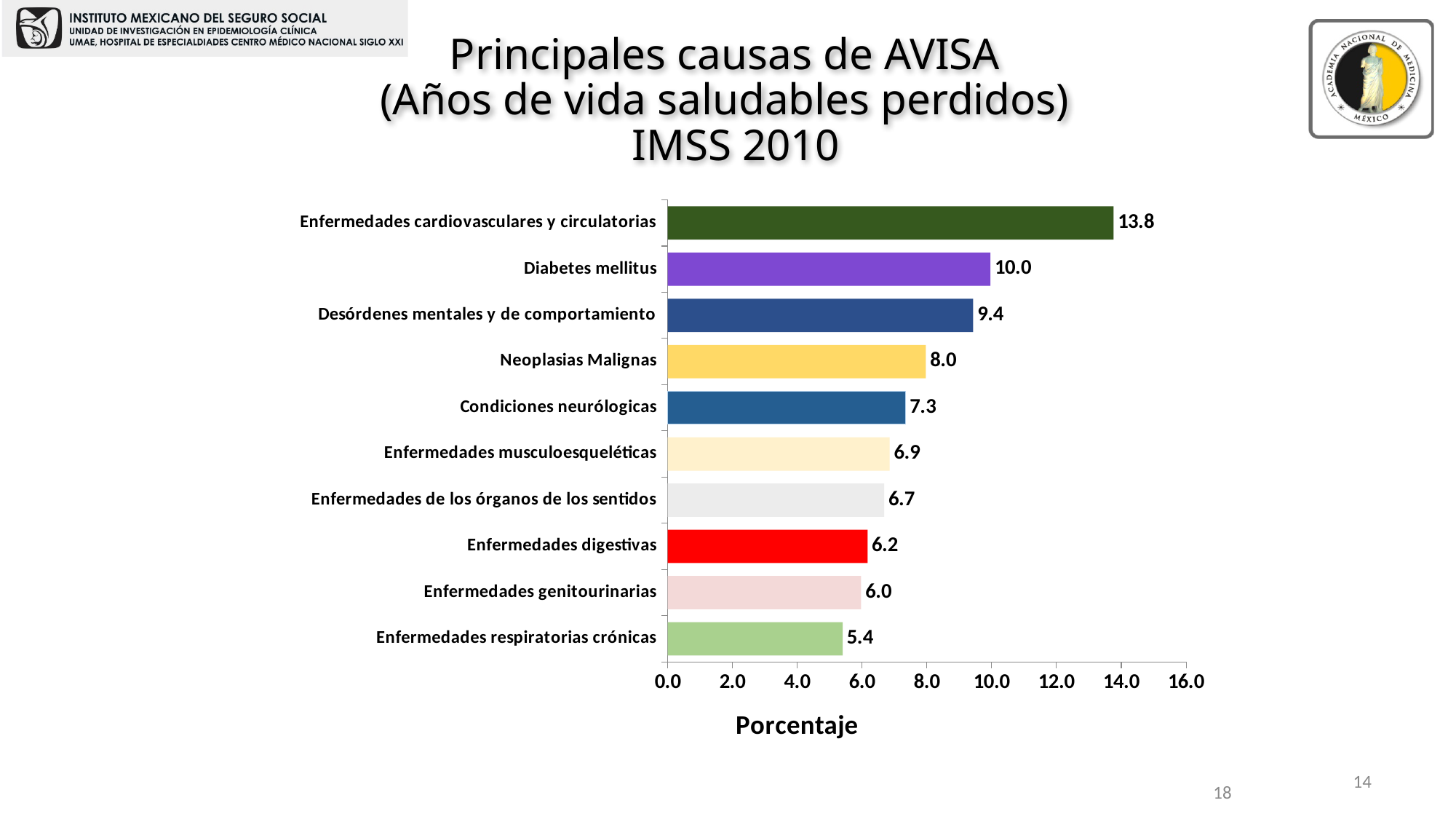
Which is larger, the value for Condiciones neurólogicas or the value for Enfermedades digestivas? Condiciones neurólogicas What is the value for Enfermedades respiratorias crónicas? 5.4 Is the value for Desórdenes mentales y de comportamiento greater or less than 8.0? greater What is the difference between the values for Enfermedades musculoesqueléticas and Enfermedades genitourinarias? 0.9 What is the label of the horizontal axis? Porcentaje What kind of chart is shown on the slide? bar chart How many categories are shown in the chart? 10 What is the difference between the values for Enfermedades cardiovasculares y circulatorias and Diabetes mellitus? 3.8 Which category has the highest value? Enfermedades cardiovasculares y circulatorias What is the value for Neoplasias Malignas? 8.0 What is the value for Diabetes mellitus? 10.0 Which category has the lowest value? Enfermedades respiratorias crónicas